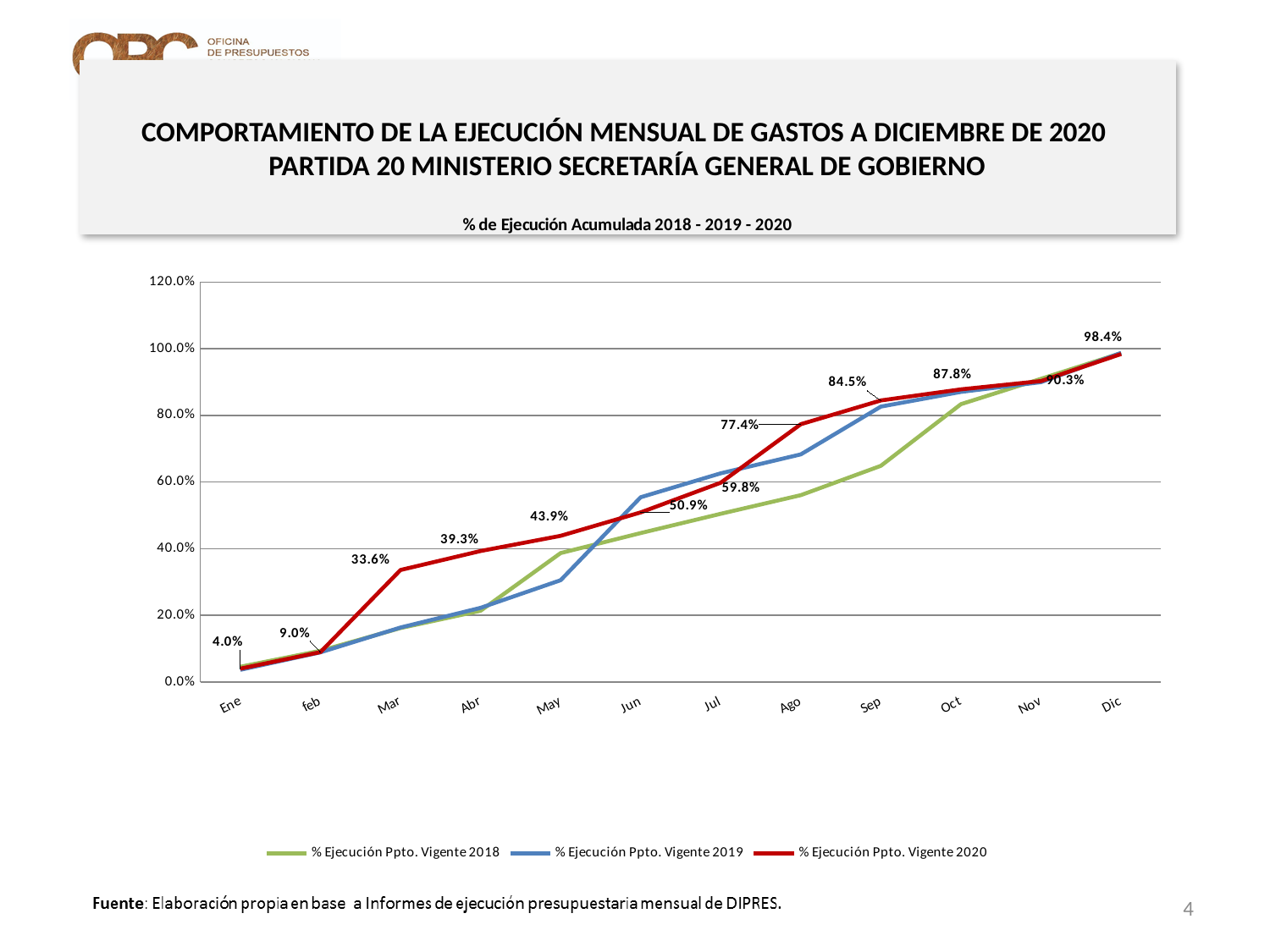
How many months are shown on the x axis? 12 What is the difference between the % Ejecución Ppto. Vigente 2020 values for Dic and Nov? 8.1% Does the % Ejecución Ppto. Vigente 2020 series rise or fall from Ene to Dic? rise What is the value of % Ejecución Ppto. Vigente 2020 in Mar? 33.6% What is the value of % Ejecución Ppto. Vigente 2020 in Ago? 77.4% What type of chart is shown on the slide? line chart What is the value of % Ejecución Ppto. Vigente 2020 in Dic? 98.4% In Ago, which series is higher: % Ejecución Ppto. Vigente 2020 or % Ejecución Ppto. Vigente 2018? % Ejecución Ppto. Vigente 2020 What is the value of % Ejecución Ppto. Vigente 2020 in Ene? 4.0% How many series does the legend list? 3 Is the value of % Ejecución Ppto. Vigente 2018 in Sep greater or less than 80.0%? less What is the difference between the % Ejecución Ppto. Vigente 2020 values for Mar and feb? 24.6%